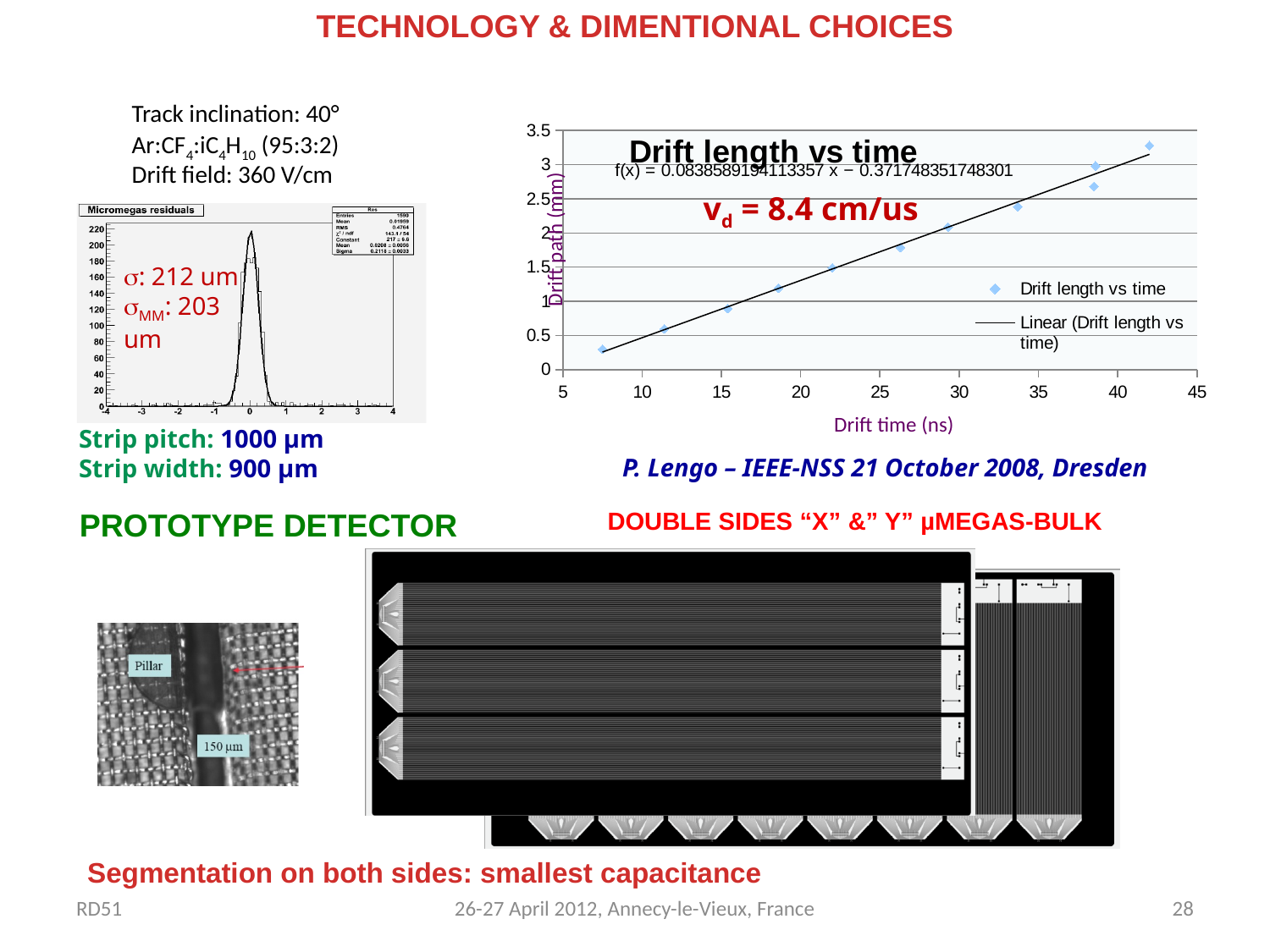
In the 'Drift length vs time' chart, is the drift path value for the point at the smallest drift time (about 7.5 ns) greater or less than 0.5? less What sigma value is annotated in red on the 'Micromegas residuals' histogram? 212 um What kind of chart is the 'Drift length vs time' chart? scatter chart What is the maximum value shown on the y-axis of the 'Drift length vs time' chart? 3.5 What is the title of the histogram on the left of the slide? Micromegas residuals What drift velocity is annotated on the 'Drift length vs time' chart? vd = 8.4 cm/us In the 'Drift length vs time' chart, does the drift path rise or fall as drift time increases? rise In the 'Drift length vs time' chart, is the drift path value for the point at the largest drift time (about 42 ns) greater or less than 3? greater How many entries does the legend of the 'Drift length vs time' chart list? 2 In the 'Drift length vs time' chart, is the drift path value for the point near 29.5 ns greater or less than 1.5? greater What is the x-axis label of the 'Drift length vs time' chart? Drift time (ns)